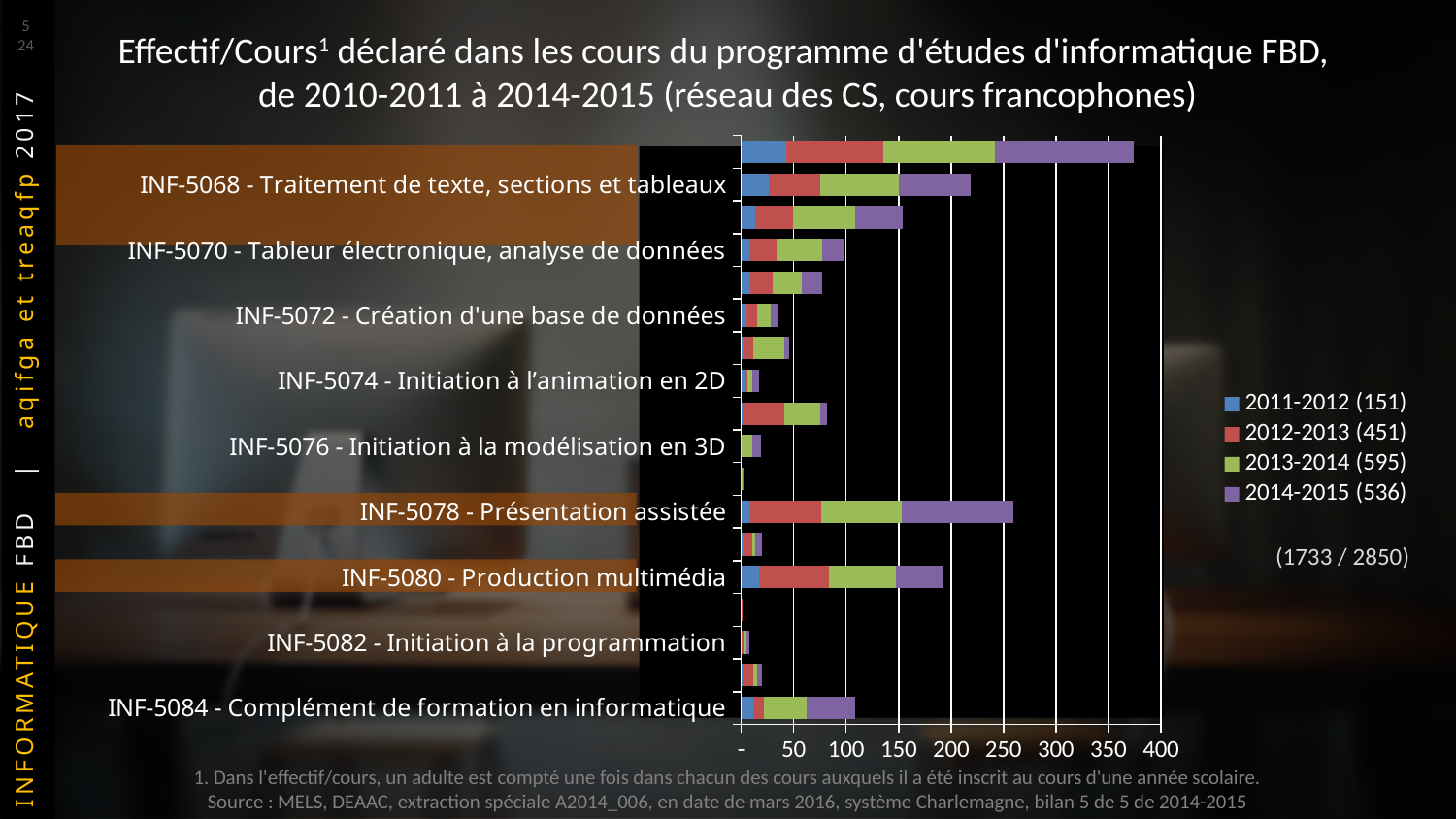
Which series has the lowest total shown in the legend? 2011-2012 (151) What is the difference between the legend totals for 2013-2014 and 2014-2015? 59 What kind of chart is shown on the slide? Stacked bar chart How many series does the legend list? 4 Which series has the highest total shown in the legend? 2013-2014 (595) Which has the longer total bar: INF-5078 - Présentation assistée or INF-5080 - Production multimédia? INF-5078 - Présentation assistée Which has the longer total bar: INF-5068 - Traitement de texte, sections et tableaux or INF-5072 - Création d'une base de données? INF-5068 - Traitement de texte, sections et tableaux Is the total bar length for INF-5070 - Tableur électronique, analyse de données greater or less than 150? less According to the legend, what is the total shown for the 2011-2012 series? 151 What colour represents the 2012-2013 series in the legend? Red Is the total bar length for INF-5078 - Présentation assistée greater or less than 200? greater According to the legend, what is the total shown for the 2013-2014 series? 595